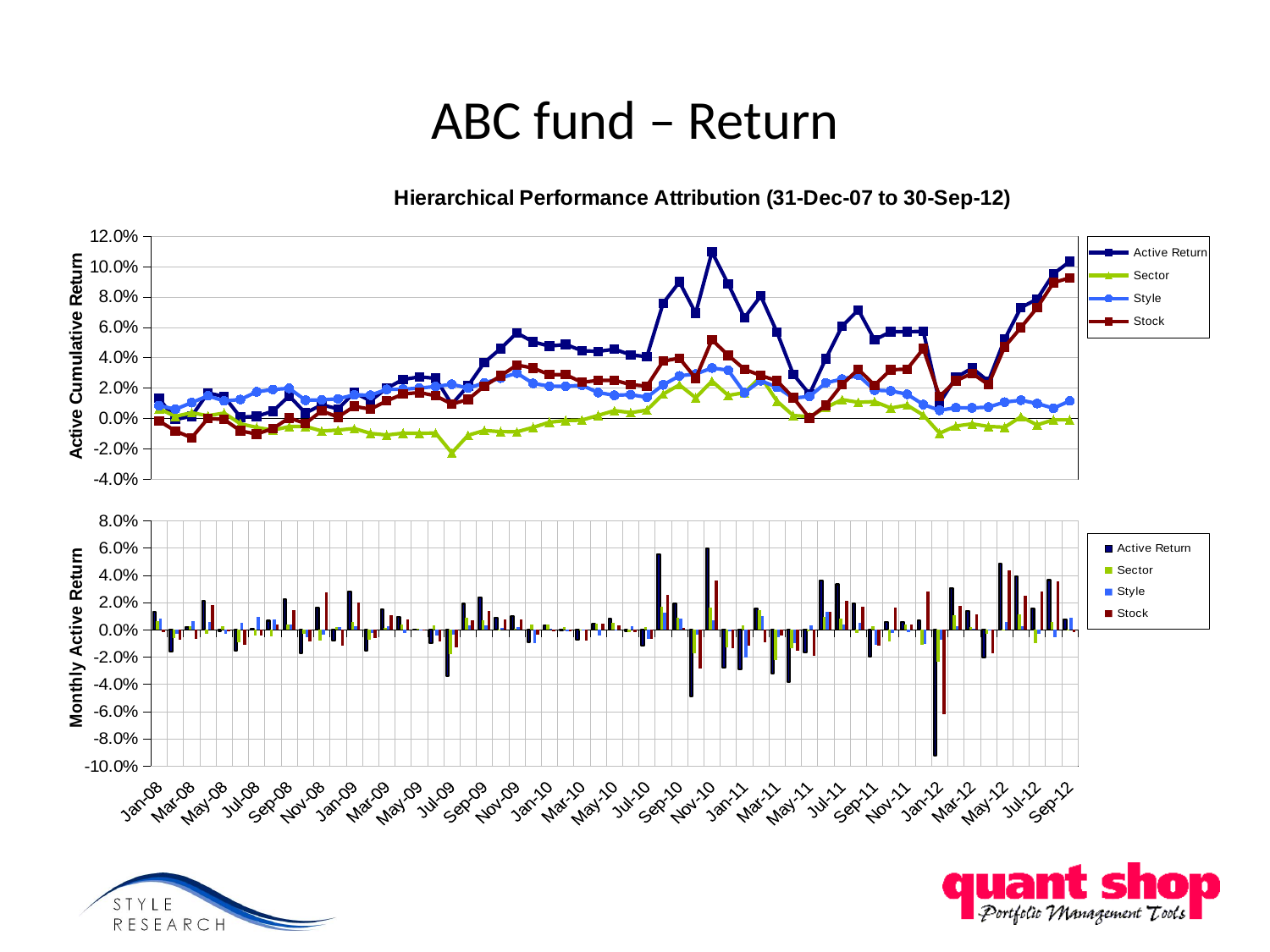
In the top chart (Active Cumulative Return), which series is higher at Sep-12: Stock or Sector? Stock In the top chart (Active Cumulative Return), which series is higher at Sep-12: Active Return or Style? Active Return In the top chart (Active Cumulative Return), does the Active Return series overall rise or fall from Jan-08 to Sep-12? rise In the top chart (Active Cumulative Return), is the Active Return value at Sep-12 greater or less than 8.0%? greater What kind of chart is the bottom chart on the slide? bar chart What kind of chart is the top chart on the slide? line chart In the top chart (Active Cumulative Return), is the Sector value at Jul-09 greater or less than 0.0%? less In the bottom chart (Monthly Active Return), is the Active Return bar for Jan-12 greater or less than -8.0%? less How many series does the legend of the top chart list? 4 What is the title shown above the charts on the slide? Hierarchical Performance Attribution (31-Dec-07 to 30-Sep-12) How many series does the legend of the bottom chart list? 4